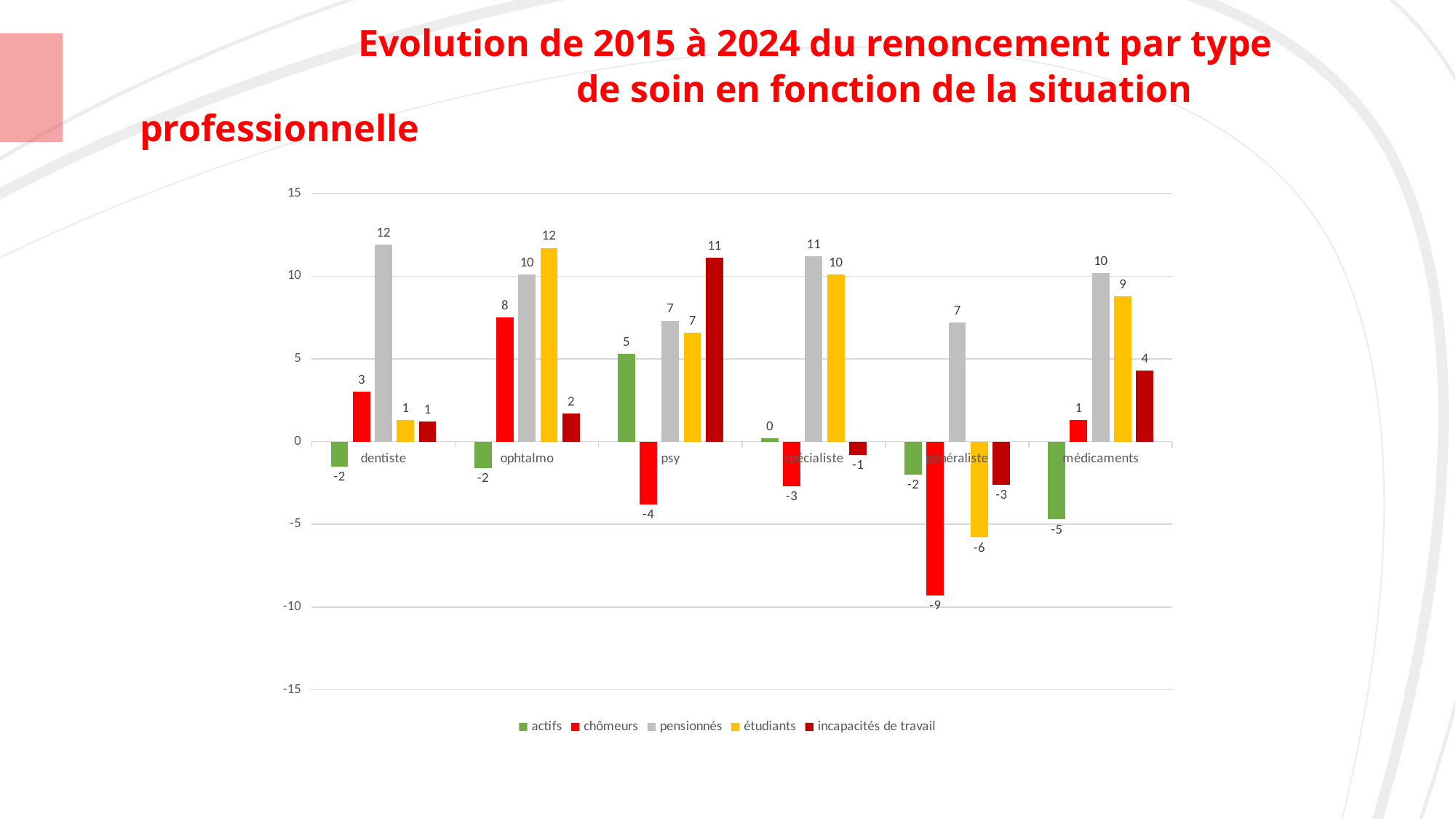
What is the value for pensionnés in the dentiste category? 12 Which category has the highest value for étudiants? ophtalmo What kind of chart is shown on the slide? bar chart How many series does the legend list? 5 What is the value for chômeurs in the généraliste category? -9 Which category has the lowest value for chômeurs? généraliste In the psy category, which is larger: the value for actifs or the value for incapacités de travail? incapacités de travail Which colour represents the pensionnés series? grey What is the value for étudiants in the médicaments category? 9 What is the difference between the pensionnés value and the chômeurs value in the ophtalmo category? 2 What is the value for incapacités de travail in the psy category? 11 How many care-type categories are shown on the x axis? 6